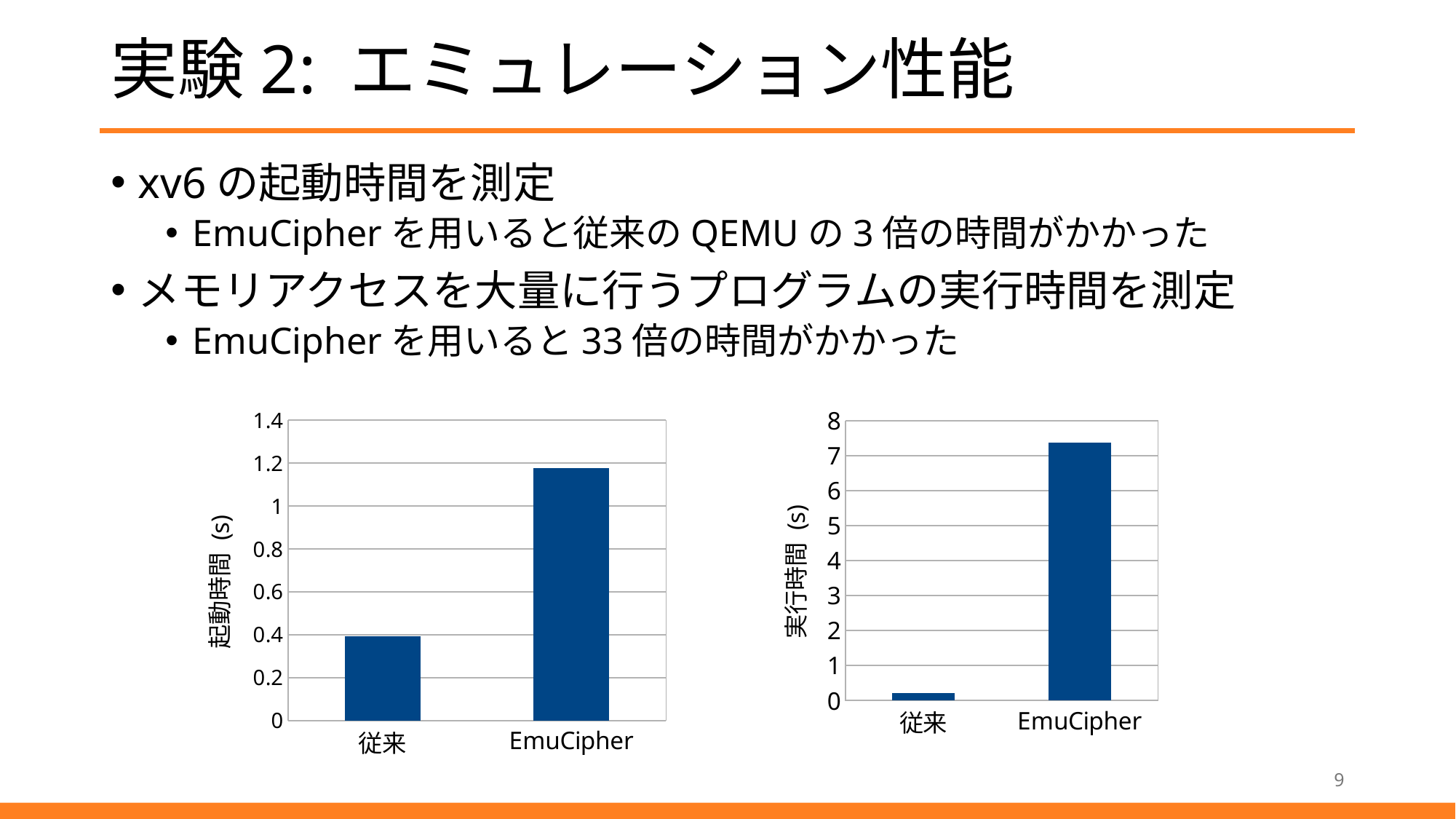
In the right chart (実行時間), which category has the lowest value? 従来 In the right chart (実行時間), is the value for 従来 greater or less than 1? less In the left chart (起動時間), is the value for 従来 greater or less than 0.6? less In the left chart (起動時間), what kind of chart is shown? bar chart In the right chart (実行時間), is the value for EmuCipher greater or less than 7? greater In the right chart (実行時間), how many categories are plotted on the x axis? 2 In the right chart (実行時間), which is larger, the value for 従来 or the value for EmuCipher? EmuCipher In the left chart (起動時間), which category has the highest value? EmuCipher In the left chart (起動時間), which category has the lowest value? 従来 What is the y-axis title of the left chart? 起動時間 (s) In the right chart (実行時間), which category has the highest value? EmuCipher